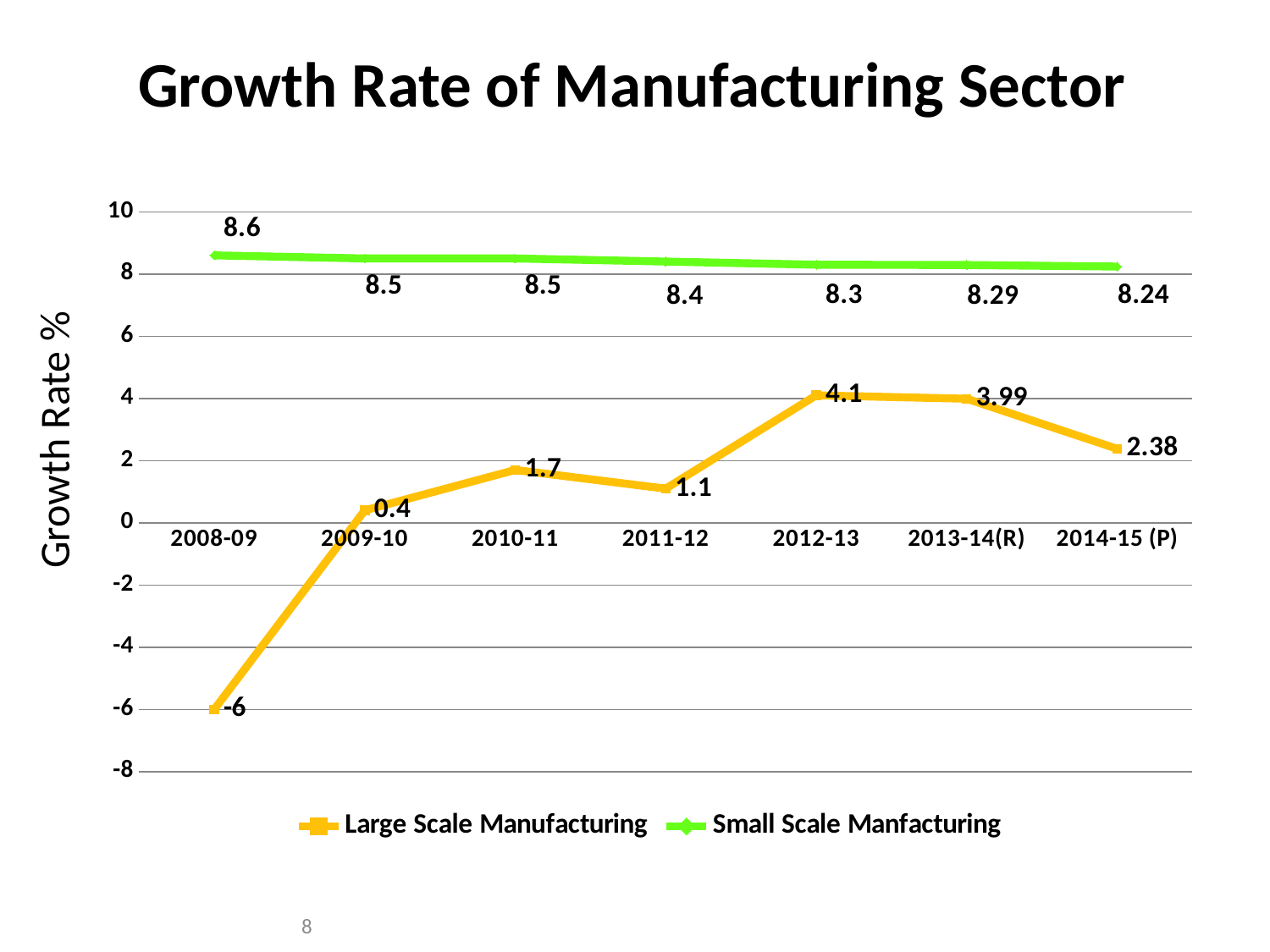
Does the Small Scale Manfacturing growth rate rise or fall from 2008-09 to 2014-15 (P)? Fall In which year is the Small Scale Manfacturing growth rate highest? 2008-09 What is the difference between the Small Scale Manfacturing and Large Scale Manufacturing growth rates in 2013-14(R)? 4.3 How many years are shown on the x axis? 7 Which series has the higher growth rate in 2011-12, Large Scale Manufacturing or Small Scale Manfacturing? Small Scale Manfacturing What is the growth rate for Large Scale Manufacturing in 2008-09? -6 What is the growth rate for Large Scale Manufacturing in 2012-13? 4.1 In which year is the Large Scale Manufacturing growth rate lowest? 2008-09 In which year is the Large Scale Manufacturing growth rate highest? 2012-13 What is the growth rate for Small Scale Manfacturing in 2014-15 (P)? 8.24 How many series does the legend list? 2 What kind of chart is shown on the slide? Line chart